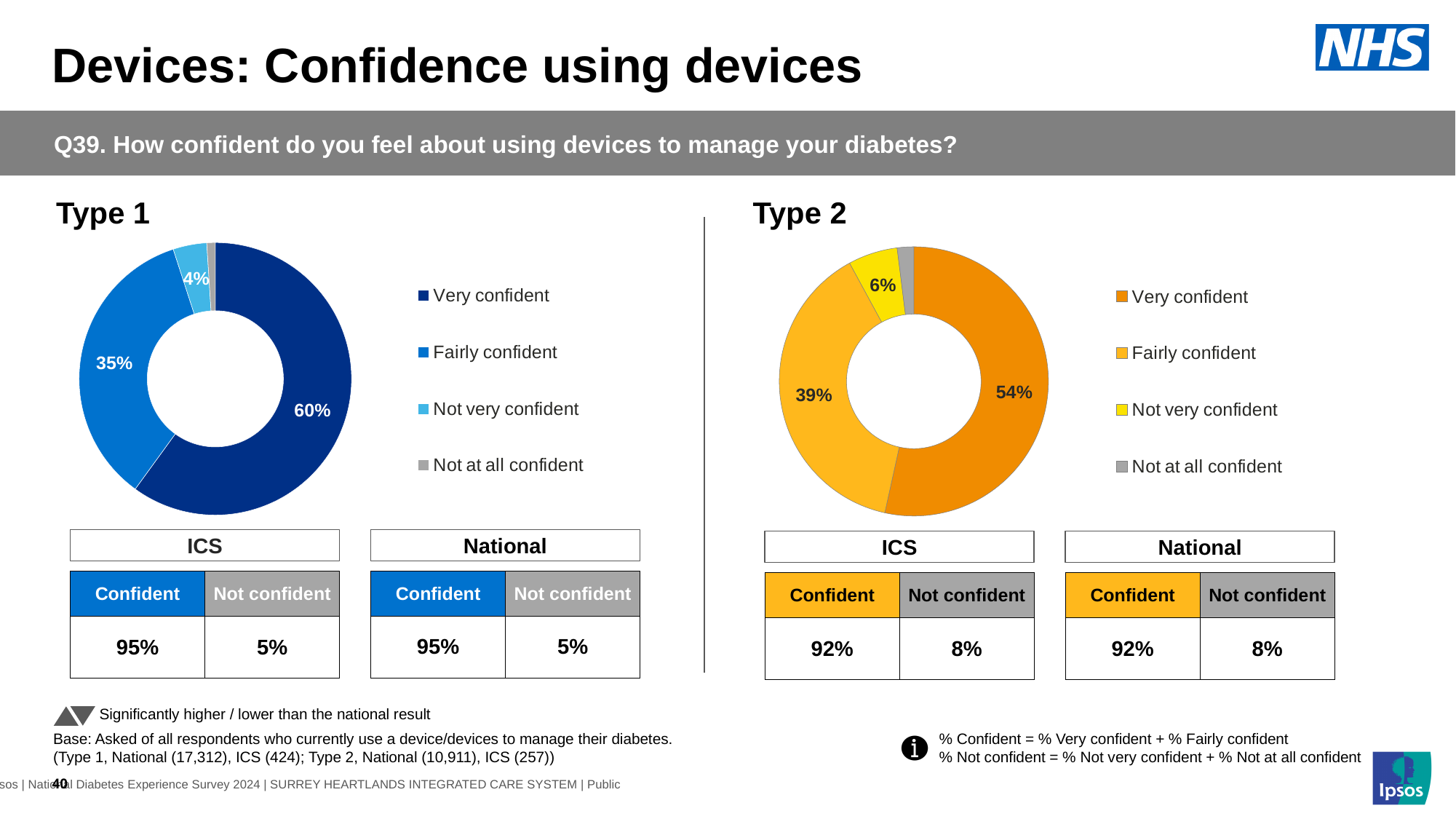
In the Type 2 chart, what percentage of respondents are not very confident? 6% How many categories does the legend of the Type 2 chart list? 4 In the Type 1 chart, what colour represents the 'Not at all confident' category? Grey In the Type 2 chart, what is the difference between the very confident and fairly confident shares? 15 percentage points In the Type 2 chart, which category has the smallest share? Not at all confident In the Type 1 chart, what percentage of respondents are fairly confident? 35% What kind of chart is used for Type 1? Donut (pie) chart In the Type 1 chart, what is the difference between the very confident and fairly confident shares? 25 percentage points In the Type 1 chart, which category has the largest share? Very confident In the Type 2 chart, what percentage of respondents are very confident? 54% In the Type 1 chart, what percentage of respondents are very confident? 60% Is the very confident share larger in the Type 1 chart or the Type 2 chart? Type 1